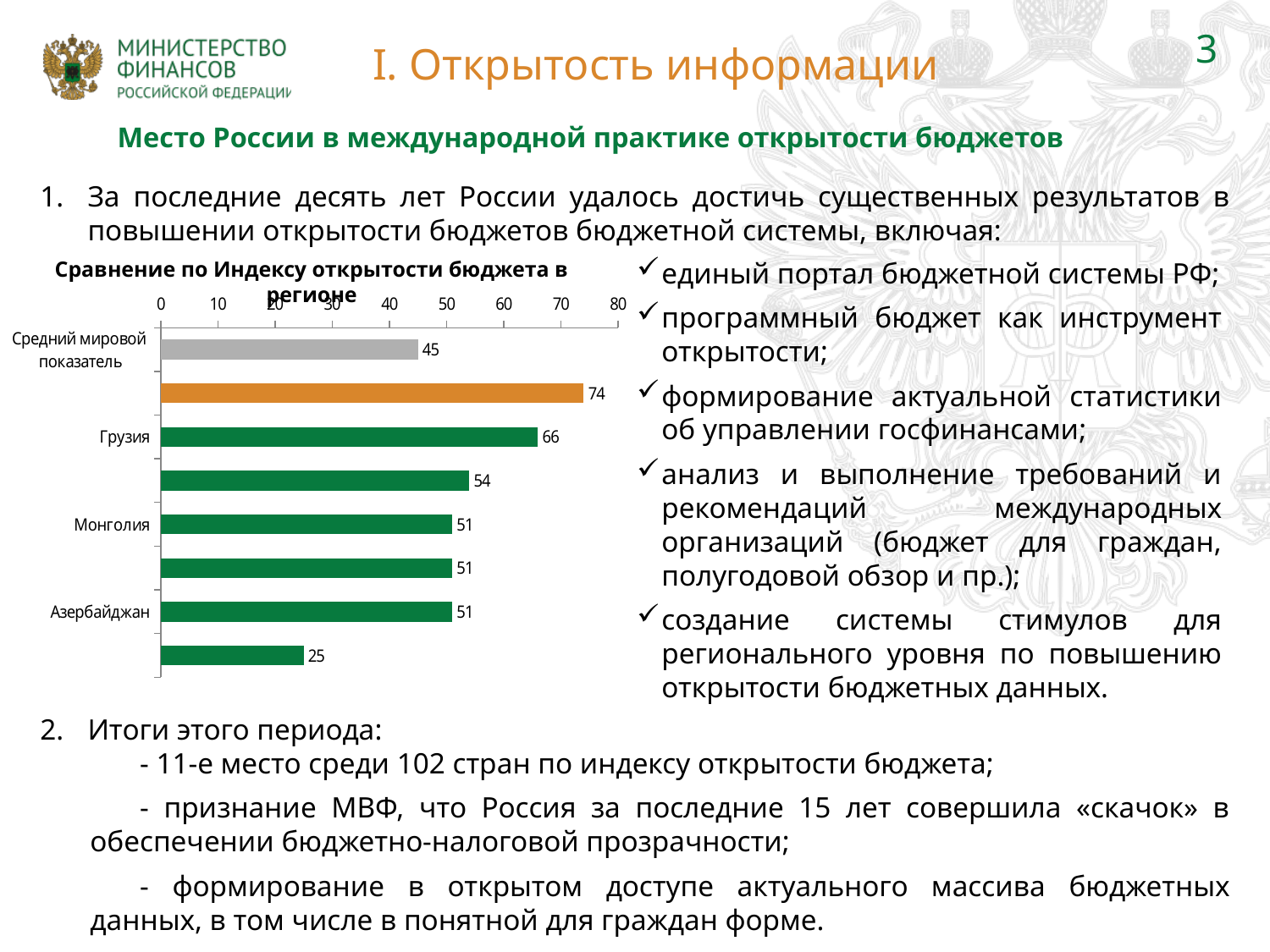
In the chart 'Сравнение по Индексу открытости бюджета в регионе', is the value for Грузия greater or less than 60? greater In the chart 'Сравнение по Индексу открытости бюджета в регионе', what is the value for Азербайджан? 51 In the chart 'Сравнение по Индексу открытости бюджета в регионе', which is larger: the value for Грузия or the value for Монголия? Грузия How many bars are plotted in the chart 'Сравнение по Индексу открытости бюджета в регионе'? 8 In the chart 'Сравнение по Индексу открытости бюджета в регионе', what colour is the bar with the value 74? orange In the chart 'Сравнение по Индексу открытости бюджета в регионе', what is the lowest value shown on any bar? 25 In the chart 'Сравнение по Индексу открытости бюджета в регионе', what is the difference between the value for Грузия and the value for Средний мировой показатель? 21 What kind of chart is 'Сравнение по Индексу открытости бюджета в регионе'? bar chart In the chart 'Сравнение по Индексу открытости бюджета в регионе', what is the value for Грузия? 66 In the chart 'Сравнение по Индексу открытости бюджета в регионе', what is the value for Средний мировой показатель? 45 In the chart 'Сравнение по Индексу открытости бюджета в регионе', what is the value for Монголия? 51 In the chart 'Сравнение по Индексу открытости бюджета в регионе', what is the highest value shown on any bar? 74